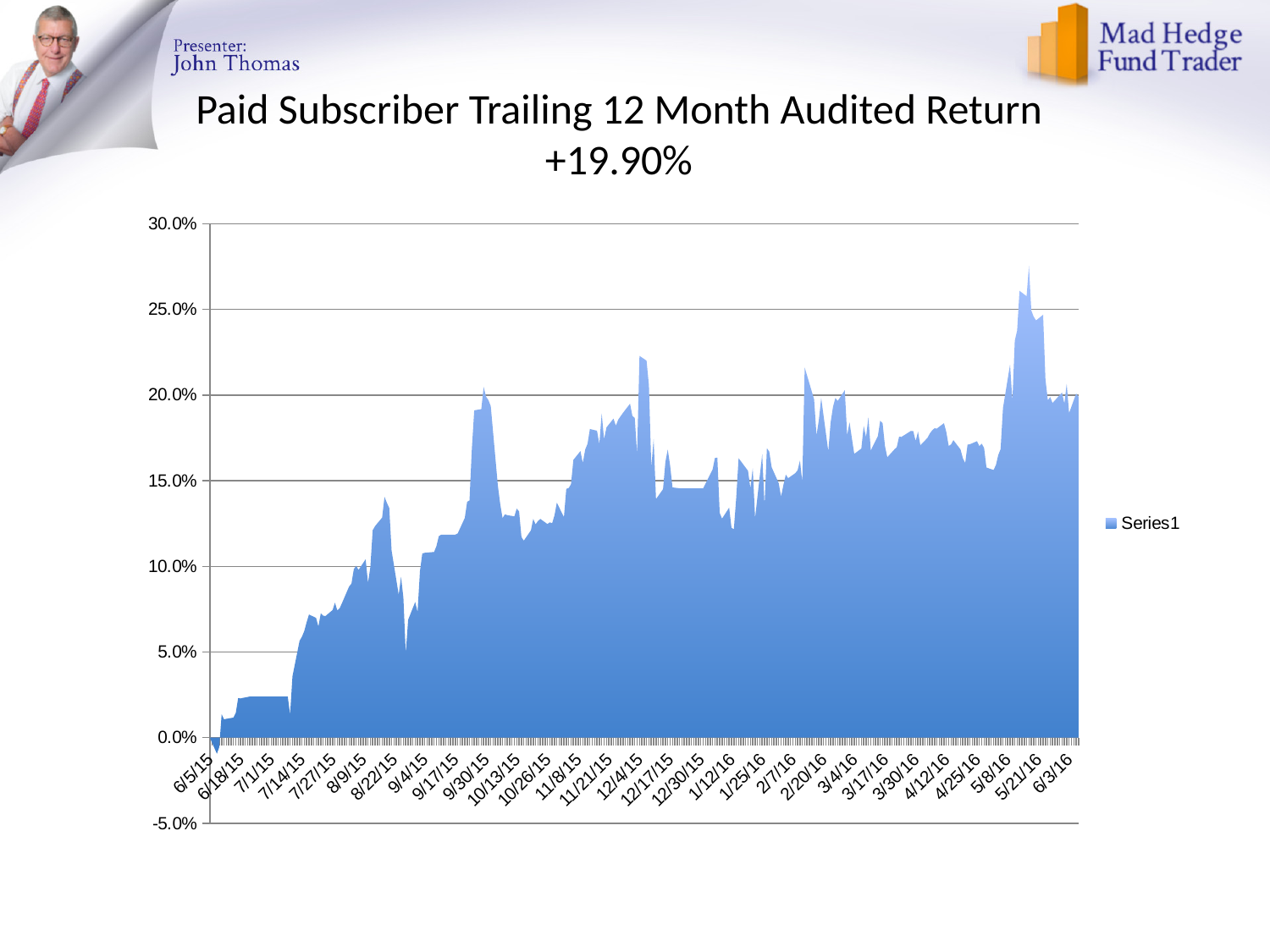
What is the highest value shown on the vertical axis? 30.0% Overall, do the values rise or fall from the start of the x axis (6/5/15) to the end (6/3/16)? rise Is the value for 6/18/15 greater or less than 5.0%? less Does the chart reach its highest value in 2015 or in 2016? 2016 Is the value for 7/27/15 greater or less than 5.0%? greater Is the highest point on the chart greater or less than 25.0%? greater How many series does the legend list? 1 What is the name of the series shown in the legend? Series1 What trailing 12 month return figure is stated in the chart title? +19.90% What kind of chart is shown on the slide? Area chart